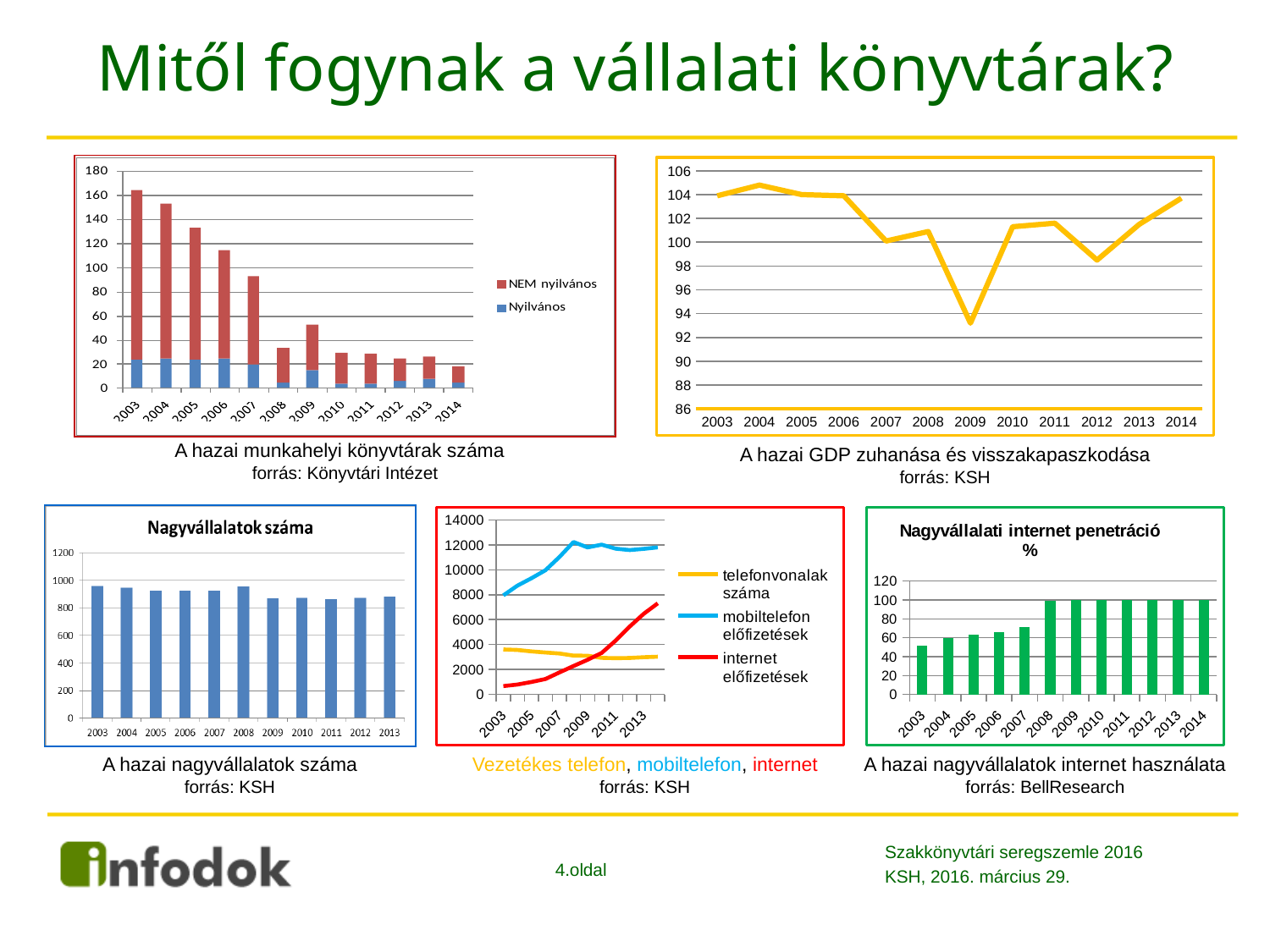
In the bottom-left chart 'Nagyvállalatok száma', is the value for 2003 greater or less than 800? greater How many series does the legend of the top-left chart 'A hazai munkahelyi könyvtárak száma' list? 2 How many series does the legend of the bottom-middle chart (telefonvonalak, mobiltelefon, internet) list? 3 In the top-right chart 'A hazai GDP zuhanása és visszakapaszkodása', is the value for 2009 greater or less than 94? less What kind of chart is the top-left chart captioned 'A hazai munkahelyi könyvtárak száma'? bar chart In the top-right chart 'A hazai GDP zuhanása és visszakapaszkodása', which year has the lowest value? 2009 How many years are shown on the x axis of the bottom-left chart 'Nagyvállalatok száma'? 11 In the bottom-middle chart, does the 'internet előfizetések' series rise or fall from 2003 to 2014? rise What kind of chart is the top-right chart 'A hazai GDP zuhanása és visszakapaszkodása'? line chart How many years are shown on the x axis of the top-left chart 'A hazai munkahelyi könyvtárak száma'? 12 In the bottom-right chart 'Nagyvállalati internet penetráció %', is the value for 2003 greater or less than 60? less In the bottom-middle chart, which series is higher in 2013: 'mobiltelefon előfizetések' or 'telefonvonalak száma'? mobiltelefon előfizetések